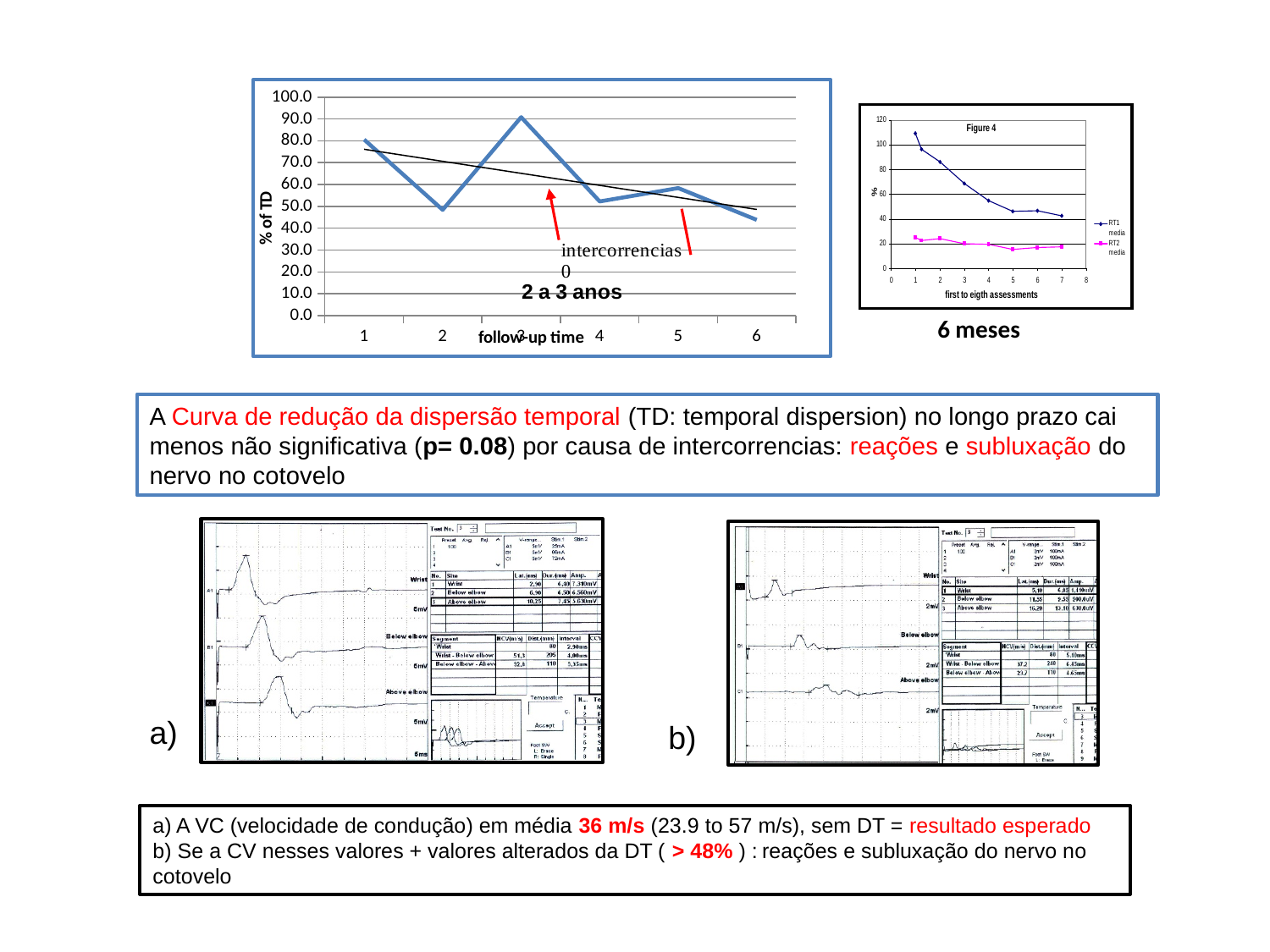
In the small chart titled 'Figure 4' on the right, how many series does the legend list? 2 What is the y-axis label of the left chart? % of TD What type of chart is the large chart on the left of the slide (with the y-axis '% of TD')? line chart In the left chart ('% of TD'), at which follow-up time is the % of TD highest? 3 In the chart titled 'Figure 4', which series has the higher value at assessment 1: RT1 media or RT2 media? RT1 media In the left chart ('% of TD'), does the straight trend line rise or fall from follow-up time 1 to 6? fall In the left chart ('% of TD'), is the value at follow-up time 3 greater or less than 80? greater In the left chart ('% of TD' vs 'follow-up time'), how many follow-up time points are plotted? 6 In the left chart ('% of TD'), is the value at follow-up time 2 greater or less than 60? less In the left chart ('% of TD'), is the value at follow-up time 6 greater or less than 50? less In the left chart ('% of TD'), which has the higher value: follow-up time 1 or follow-up time 4? follow-up time 1 In the chart titled 'Figure 4', does the RT1 media series rise or fall across the assessments? fall